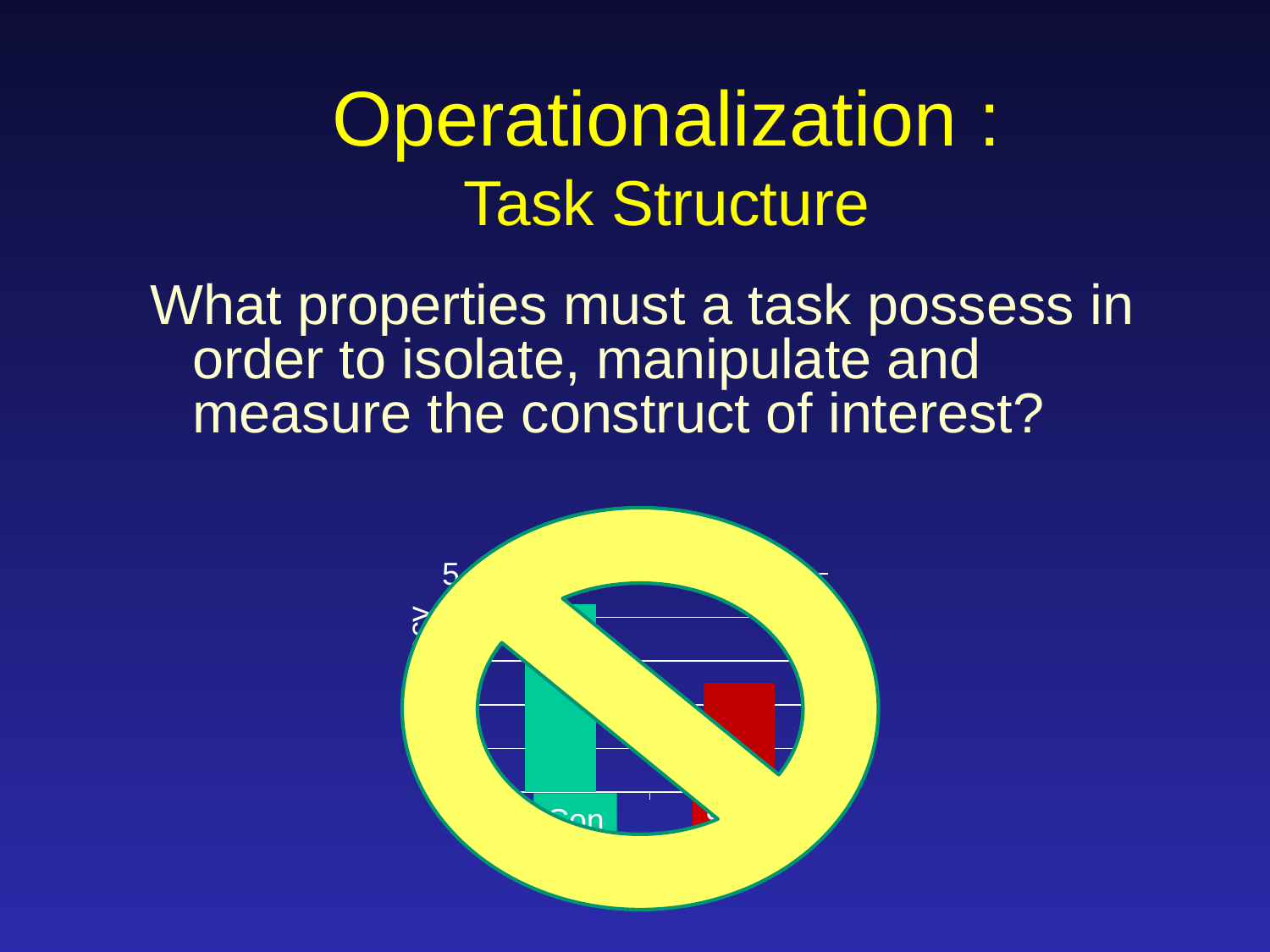
What symbol is drawn over the chart on the slide? a yellow prohibition (no) sign What kind of chart is partially visible behind the prohibition symbol on the slide? bar chart How many bars are visible in the chart on the slide? 2 Which bar in the chart is taller, the green one or the red one? the green one What is the topmost tick value shown on the chart's y axis? 5